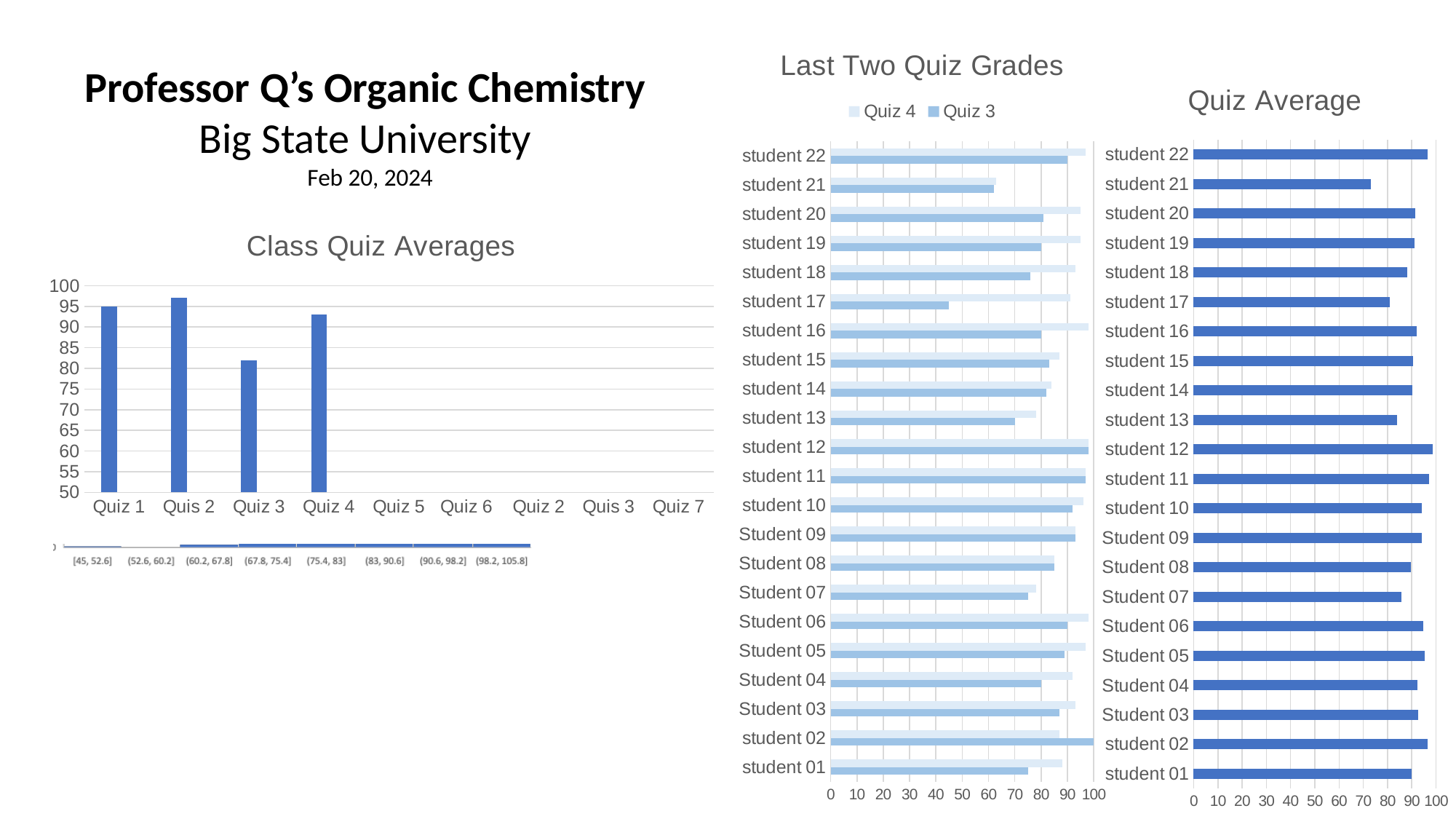
What are the legend entries of the 'Last Two Quiz Grades' chart? Quiz 4 and Quiz 3 In the 'Class Quiz Averages' chart, which quiz has the highest average? Quis 2 In the 'Class Quiz Averages' chart, is the value for Quiz 4 greater or less than 90? greater What kind of chart is the 'Class Quiz Averages' chart? bar chart How many students are shown in the 'Last Two Quiz Grades' chart? 22 In the 'Class Quiz Averages' chart, is the value for Quiz 3 greater or less than 85? less In the 'Class Quiz Averages' chart, which of the quizzes with a plotted bar has the lowest average? Quiz 3 In the 'Last Two Quiz Grades' chart, which is larger for student 17, the Quiz 4 value or the Quiz 3 value? Quiz 4 How many series does the legend of the 'Last Two Quiz Grades' chart list? 2 In the 'Quiz Average' chart, which student has the lowest quiz average? student 21 In the 'Last Two Quiz Grades' chart, is the Quiz 3 value for student 17 greater or less than 50? less How many categories are labelled on the x axis of the 'Class Quiz Averages' chart? 9